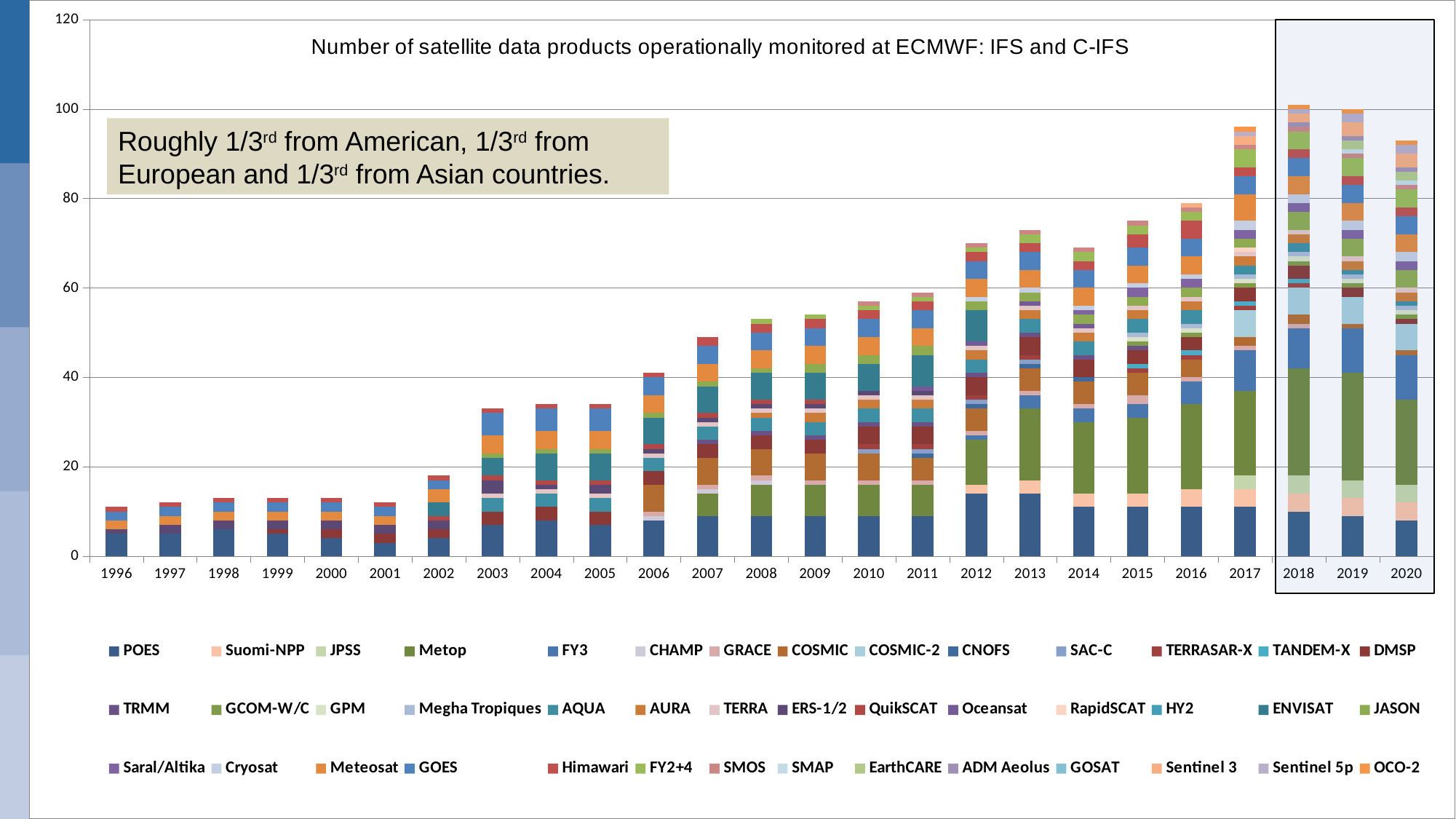
Is the total value for 2017 greater or less than 100? less What is the title of the chart? Number of satellite data products operationally monitored at ECMWF: IFS and C-IFS How many series does the chart's legend list? 42 Which year has the larger total, 2007 or 2012? 2012 Is the total value for 2014 greater or less than 60? greater Is the total value for 2016 greater or less than 60? greater Which years are enclosed in the highlighted box on the right of the chart? 2018, 2019 and 2020 Do the total values generally rise or fall from 1996 to 2018? Rise How many years are shown along the x axis of the chart? 25 What kind of chart is shown on the slide? Stacked bar chart